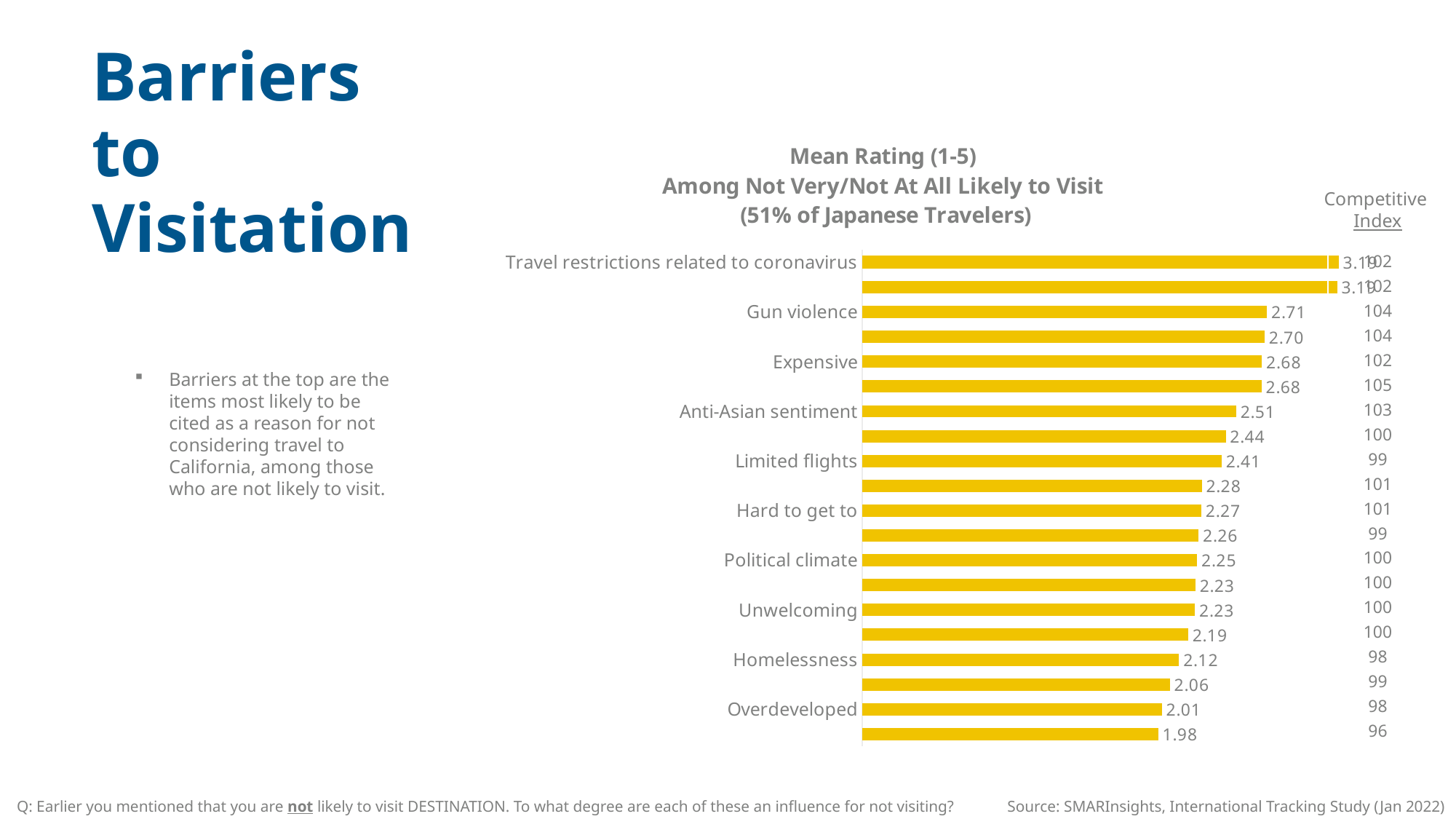
What is the mean rating for Expensive? 2.68 What kind of chart is shown on the slide? Bar chart What is the mean rating for Anti-Asian sentiment? 2.51 What is the Competitive Index value shown for Gun violence? 104 What is the difference between the mean ratings for Homelessness and Overdeveloped? 0.11 What is the mean rating for Gun violence? 2.71 Which has a higher mean rating, Gun violence or Homelessness? Gun violence What is the mean rating for Limited flights? 2.41 What is the difference between the mean ratings for Anti-Asian sentiment and Limited flights? 0.10 Do the mean ratings increase or decrease from the top bar to the bottom bar? Decrease What is the mean rating for Overdeveloped? 2.01